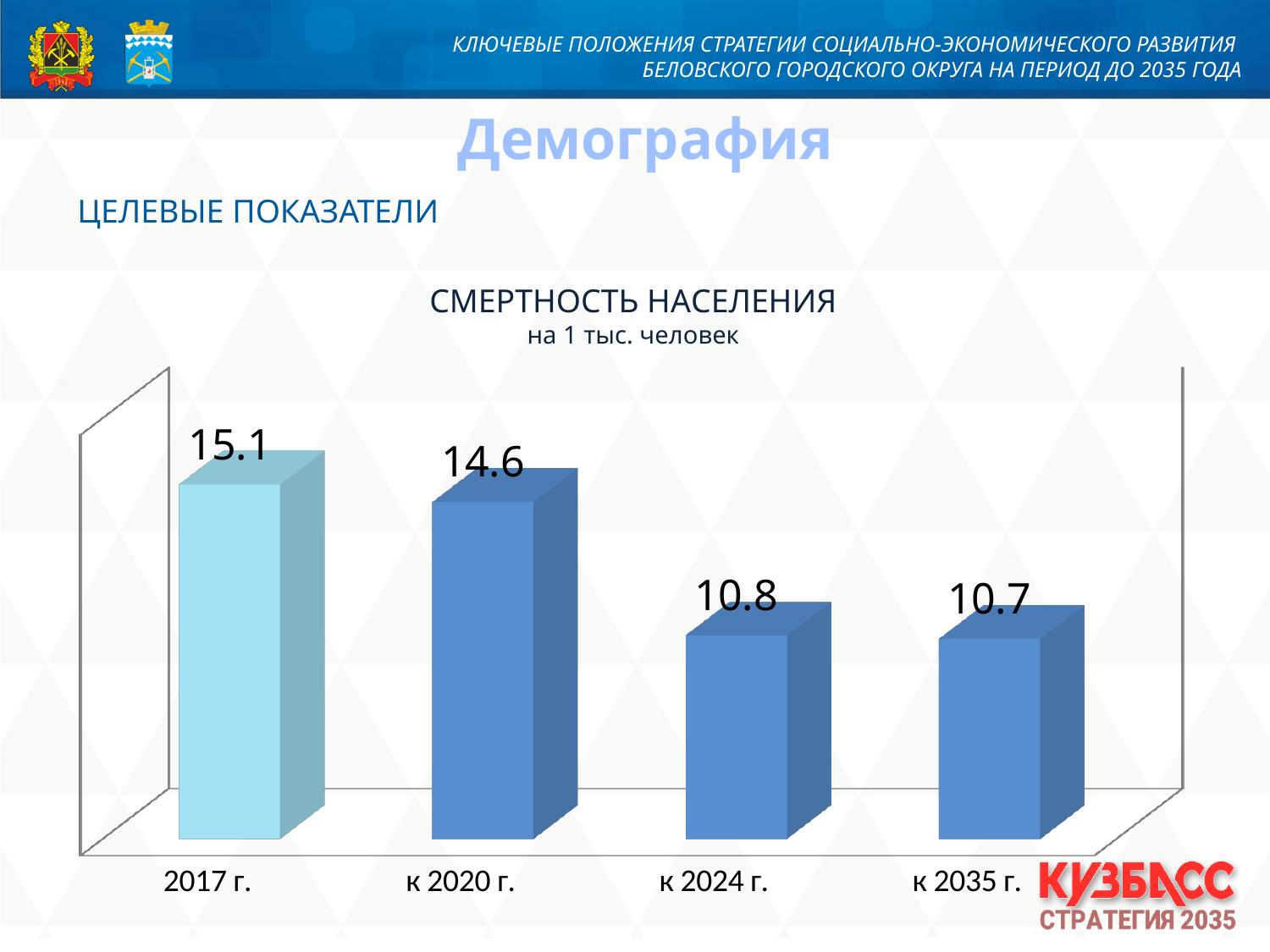
What is the difference between the values for к 2020 г. and к 2024 г.? 3.8 How many categories are shown on the chart? 4 What kind of chart is this? bar chart Which is larger, the value for 2017 г. or the value for к 2020 г.? 2017 г. What is the value for к 2020 г.? 14.6 Which category has the highest value? 2017 г. Do the values rise or fall from 2017 г. to к 2035 г.? fall Which category has the lowest value? к 2035 г. What is the value for 2017 г.? 15.1 What is the value for к 2024 г.? 10.8 What is the value for к 2035 г.? 10.7 What is the difference between the values for 2017 г. and к 2035 г.? 4.4